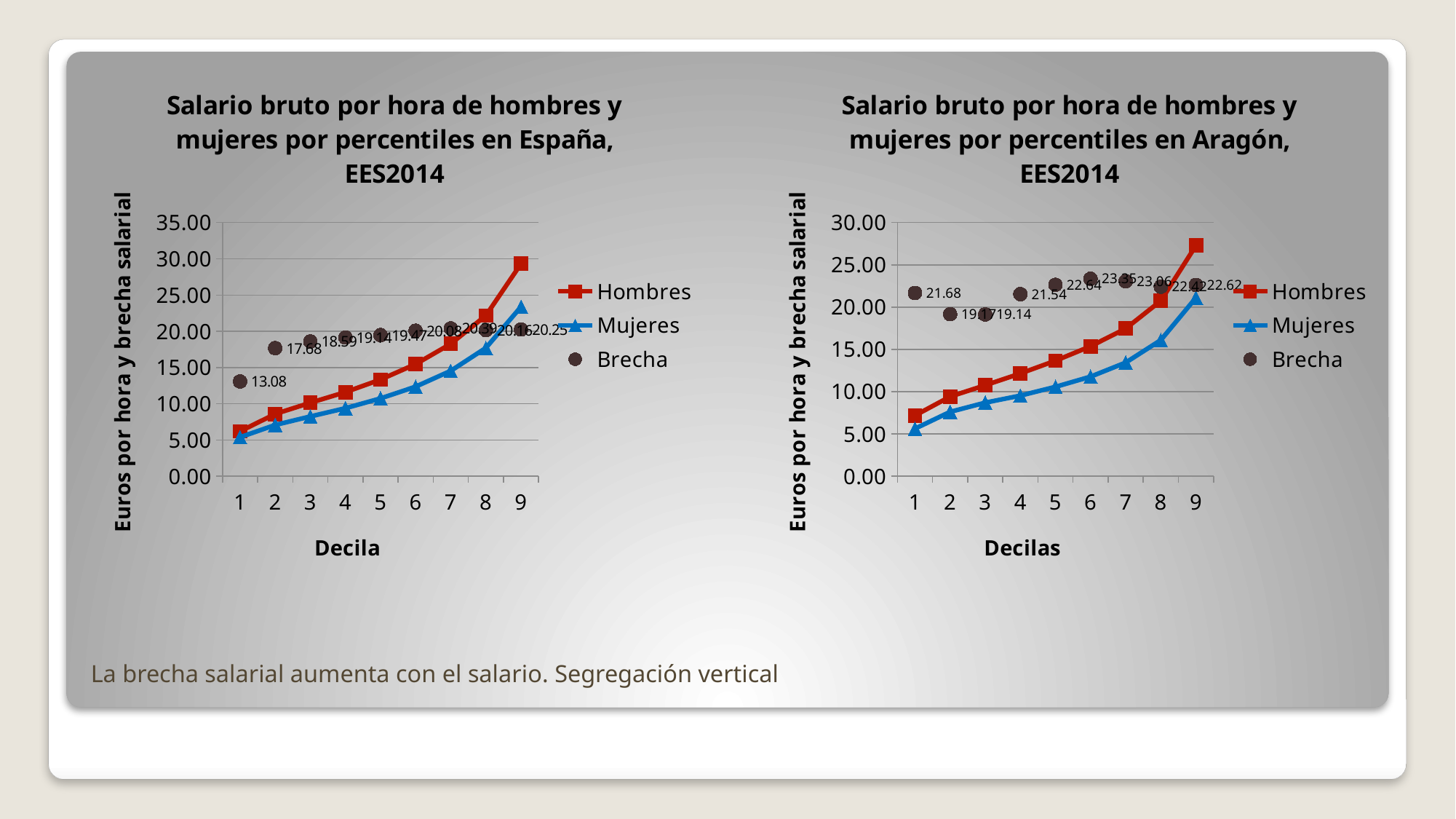
In the España chart, what is the Brecha value at decile 2? 17.68 In the España chart, what is the difference between the Brecha values at decile 2 and decile 1? 4.60 In the España chart, what is the Brecha value at decile 1? 13.08 In the Aragón chart, which is larger: the Brecha value at decile 1 or at decile 2? decile 1 In the Aragón chart, at which decile is the Brecha value highest? 6 In the Aragón chart, what is the Brecha value at decile 1? 21.68 How many deciles are shown on the x axis of the España chart? 9 How many series does the legend of the Aragón chart list? 3 In the Aragón chart, what is the Brecha value at decile 6? 23.35 In the Aragón chart, is the Mujeres value at decile 1 greater or less than 10.00? less In the España chart, at which decile is the Brecha value lowest? 1 In the España chart, is the Hombres value at decile 9 greater or less than 25.00? greater